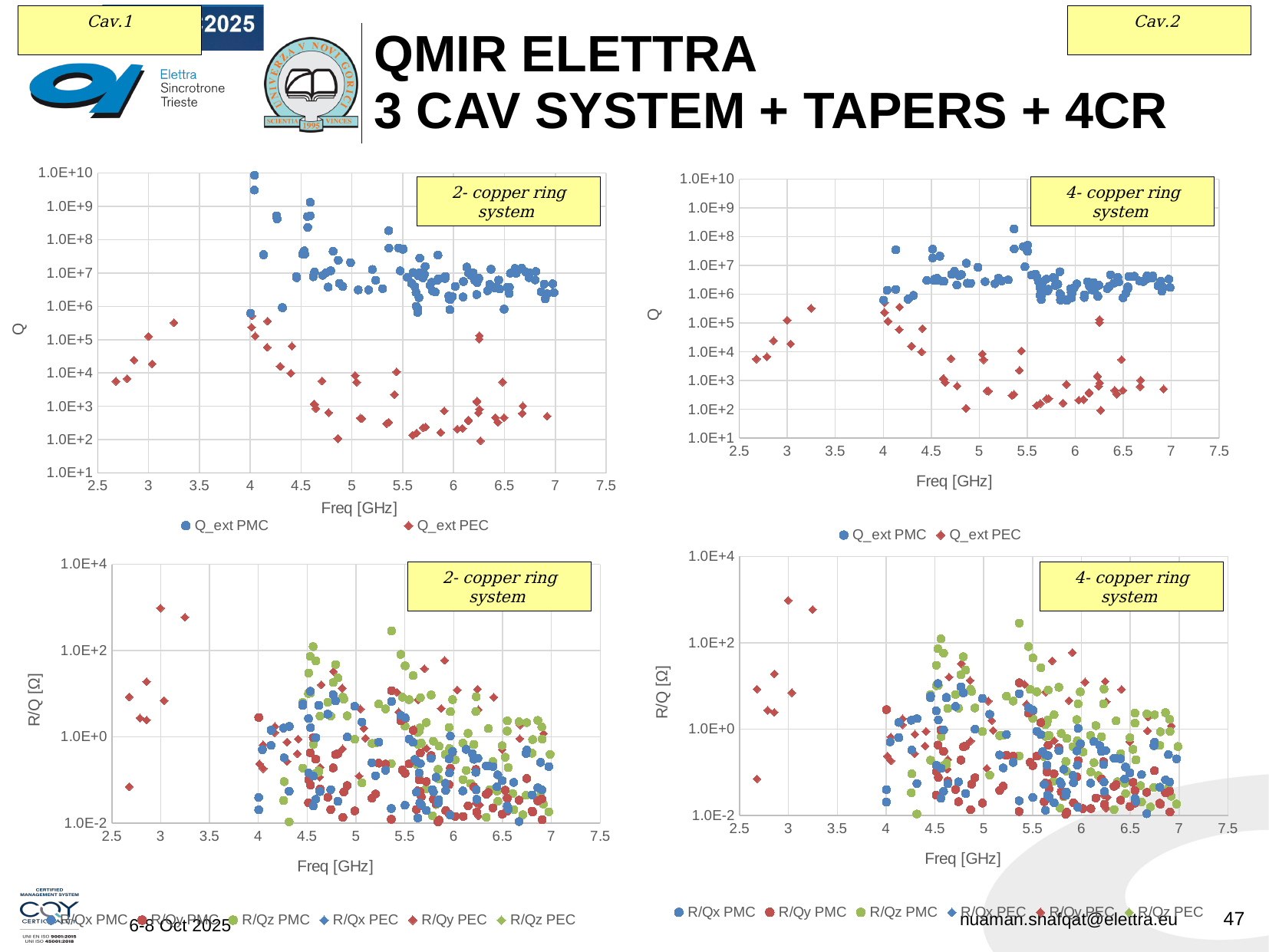
How many charts are shown on the slide? 4 In the top-right Q chart ('4- copper ring system'), is the lowest Q_ext PEC value greater or less than 1.0E+3? less What is the x-axis label of the bottom-left R/Q chart ('2- copper ring system')? Freq [GHz] In the top-left Q chart ('2- copper ring system'), which series has the higher values overall above 4 GHz, Q_ext PMC or Q_ext PEC? Q_ext PMC In the top-left Q chart ('2- copper ring system'), is the highest Q_ext PMC value greater or less than 1.0E+9? greater In the top-right Q chart ('4- copper ring system'), is the highest Q_ext PMC value greater or less than 1.0E+9? less What are the two legend entries of the top-right Q chart ('4- copper ring system')? Q_ext PMC, Q_ext PEC How many series does the legend of the bottom-right R/Q chart ('4- copper ring system') list? 6 How many series does the legend of the top-left Q chart ('2- copper ring system') list? 2 What kind of chart is the top-left chart titled '2- copper ring system' (Q vs Freq)? scatter chart What is the y-axis label of the bottom-right chart ('4- copper ring system')? R/Q [Ω]